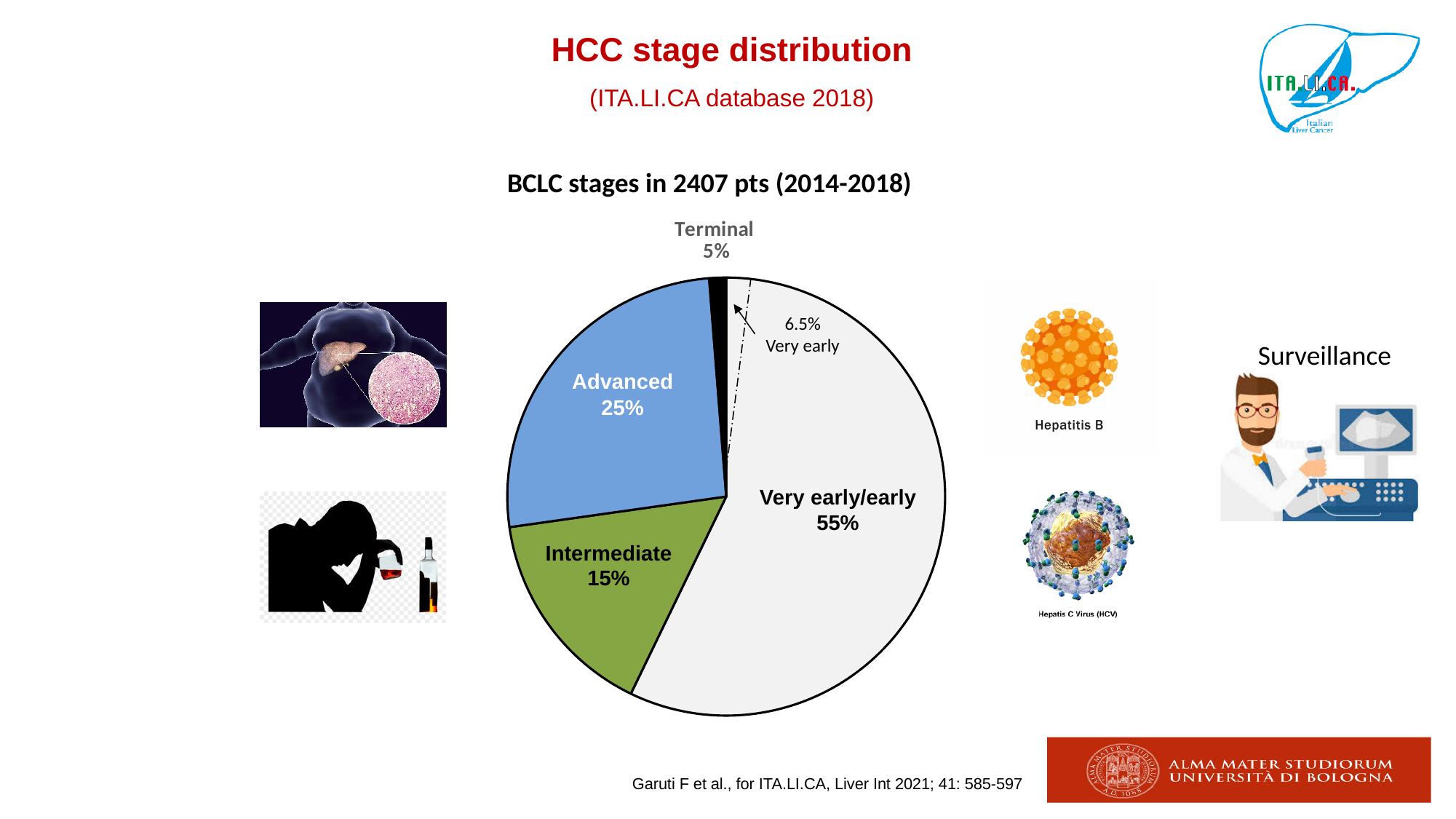
What colour is the Intermediate slice? Green Which BCLC stage has the smallest share of patients? Terminal What kind of chart is shown on the slide? Pie chart What is the difference in percentage points between the Advanced and Intermediate stages? 10 What percentage is labelled as Very early by the arrow annotation? 6.5% What percentage of patients are in the Very early/early stage? 55% Which BCLC stage has the largest share of patients? Very early/early What is the title of the chart? BCLC stages in 2407 pts (2014-2018) What percentage of patients are in the Terminal stage? 5% What percentage of patients are in the Advanced stage? 25% Which stage has a larger share, Advanced or Intermediate? Advanced What percentage of patients are in the Intermediate stage? 15%